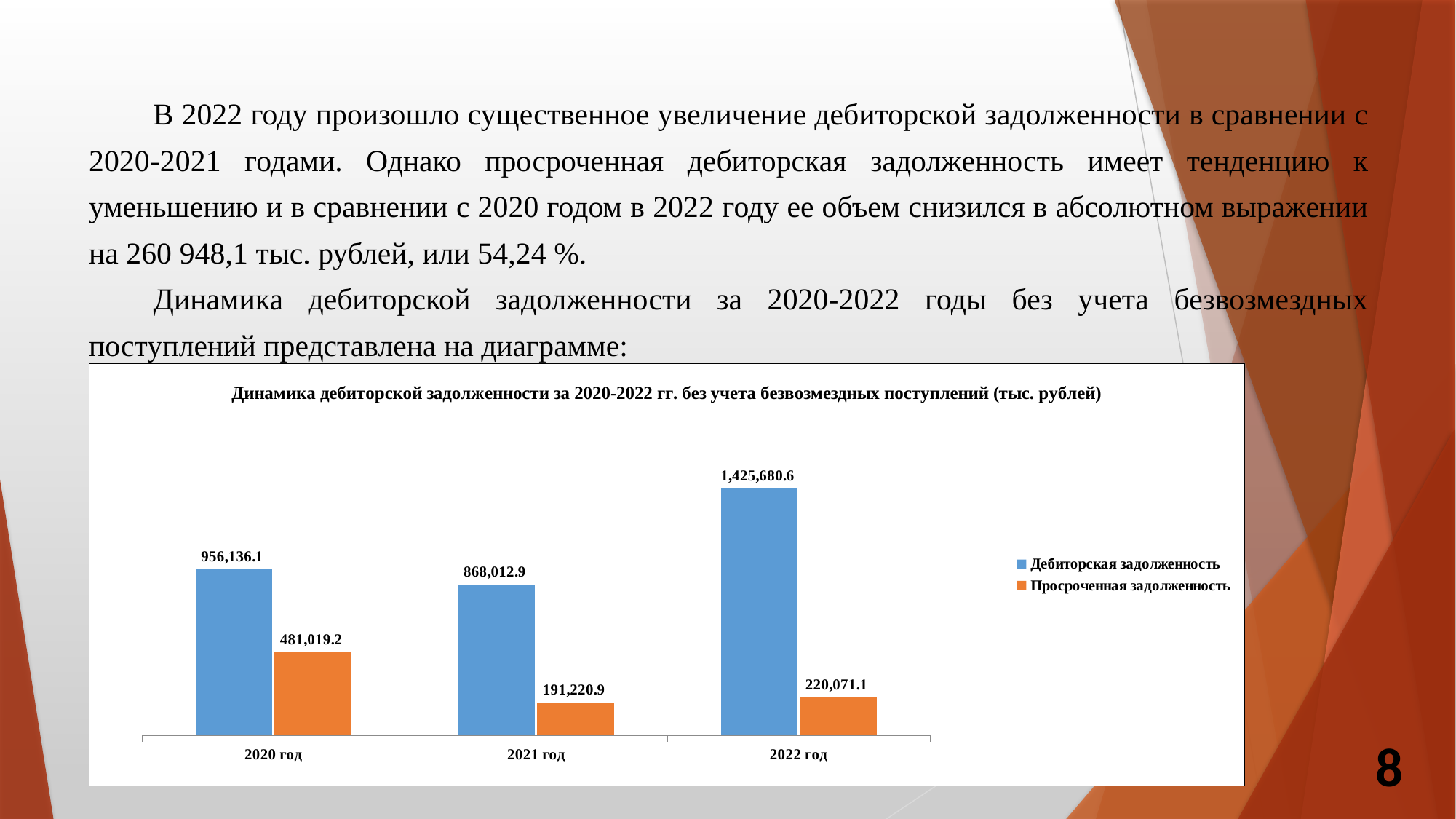
Which is larger: Просроченная задолженность in 2021 год or in 2022 год? 2022 год What is the value of Просроченная задолженность for 2021 год? 191,220.9 What is the difference between Дебиторская задолженность in 2022 год and in 2020 год? 469,544.5 How many series does the legend list? 2 How many years (categories) are shown on the x axis? 3 What is the difference between Просроченная задолженность in 2020 год and in 2022 год? 260,948.1 What is the value of Дебиторская задолженность for 2020 год? 956,136.1 In which year is Дебиторская задолженность the lowest? 2021 год What is the value of Дебиторская задолженность for 2022 год? 1,425,680.6 What type of chart is shown on the slide? Bar chart Which colour represents Просроченная задолженность in the chart? Orange In which year is Просроченная задолженность the highest? 2020 год